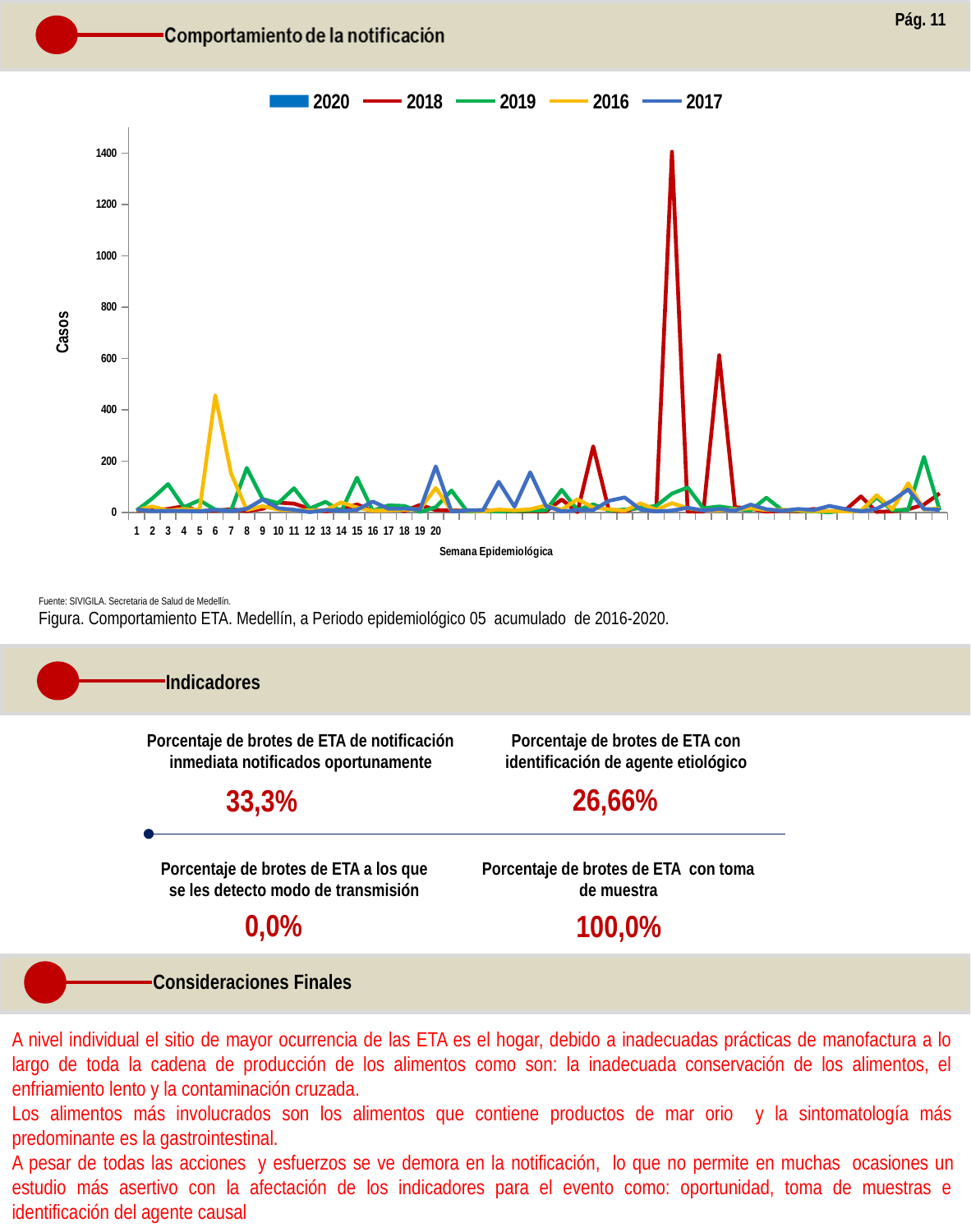
How many series does the chart legend list? 5 What is the label of the horizontal axis of the chart? Semana Epidemiológica Is the highest value of the 2017 series greater or less than 400? less At which labeled epidemiological week does the 2016 series reach its peak? 6 Which is larger, the highest peak of the 2018 series or the highest peak of the 2016 series? 2018 What kind of chart is shown on the slide? combination bar and line chart Is the highest value of the 2019 series greater or less than 400? less Is the peak of the 2016 series at week 6 greater or less than 200? greater Which series reaches the highest value on the chart? 2018 What is the label of the vertical axis of the chart? Casos